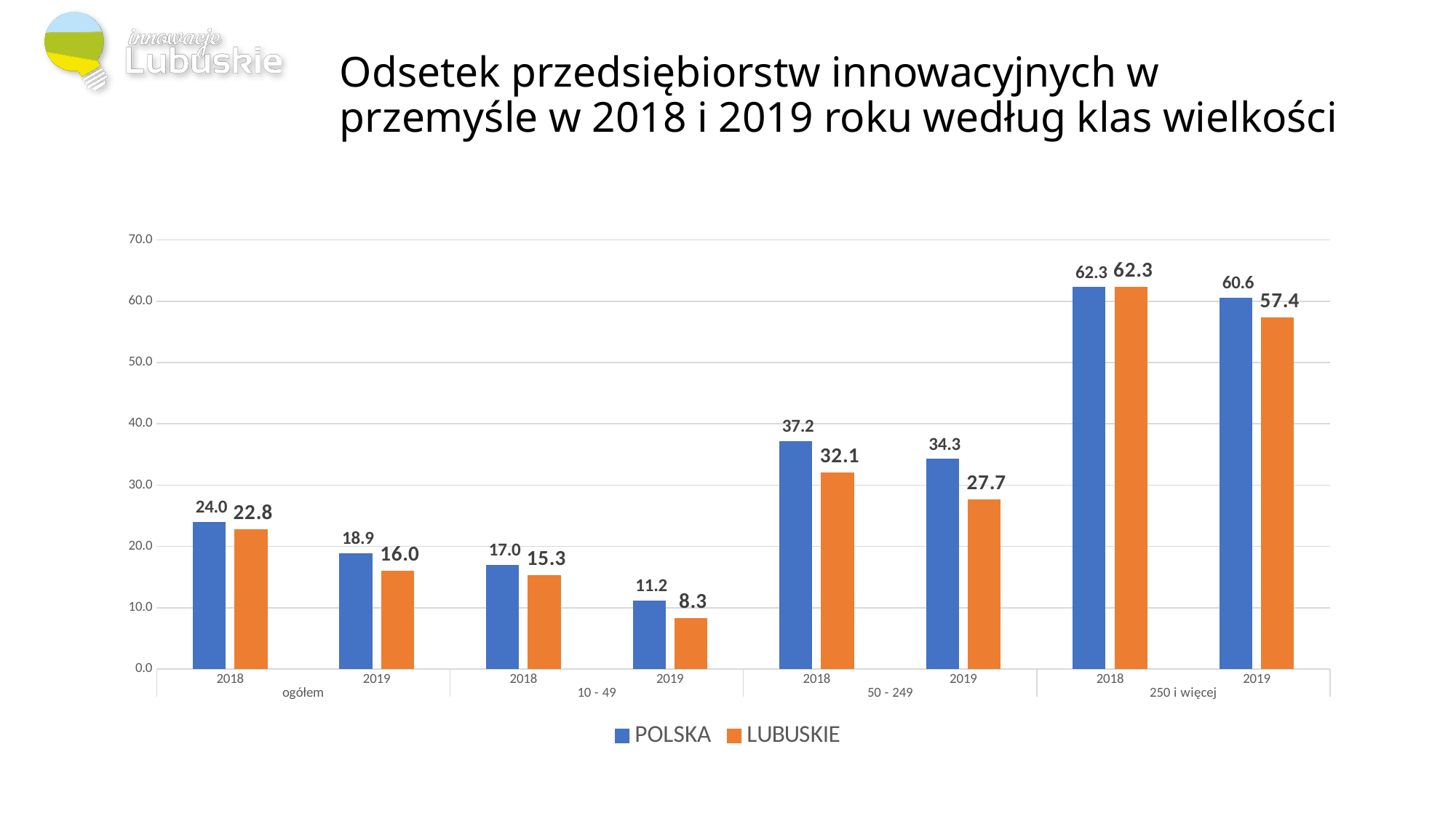
How many series does the legend list? 2 What kind of chart is shown on the slide? Bar chart What is the difference between the POLSKA values for 2018 and 2019 in the 'ogółem' group? 5.1 What is the value for LUBUSKIE in 2019 for the '250 i więcej' group? 57.4 What is the difference between the POLSKA and LUBUSKIE values in 2018 for the '50 - 249' group? 5.1 Which colour represents LUBUSKIE in the chart? Orange What is the value for LUBUSKIE in 2019 for the '10 - 49' group? 8.3 What is the value for POLSKA in 2019 for the '50 - 249' group? 34.3 Which is larger in 2019 for the '250 i więcej' group: POLSKA or LUBUSKIE? POLSKA Which group and year has the lowest LUBUSKIE value? 10 - 49, 2019 How many size-class groups are shown on the x axis? 4 What is the value for POLSKA in 2018 for the 'ogółem' group? 24.0